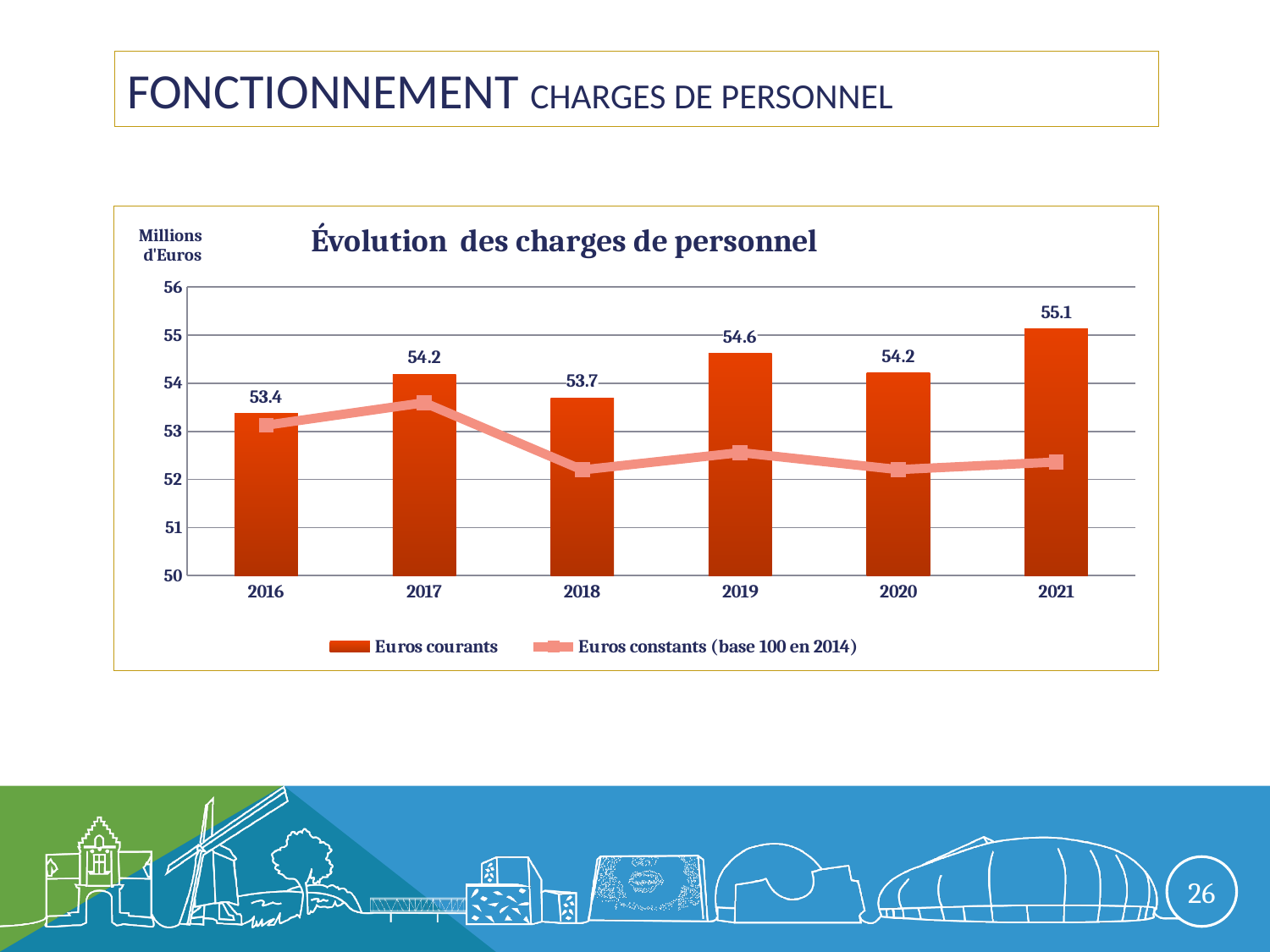
Is the Euros constants value for 2017 greater or less than 53? greater Which year has the highest value for Euros courants? 2021 Which year has the lowest value for Euros courants? 2016 How many series does the legend list? 2 What is the difference between the Euros courants values for 2021 and 2016? 1.7 Which year has the larger Euros courants value, 2017 or 2018? 2017 What is the title of the chart? Évolution des charges de personnel What is the value of Euros courants for 2018? 53.7 What is the value of Euros courants for 2021? 55.1 Does the Euros courants value rise or fall from 2020 to 2021? rise Is the Euros constants value for 2018 greater or less than 53? less How many years are shown on the x axis? 6